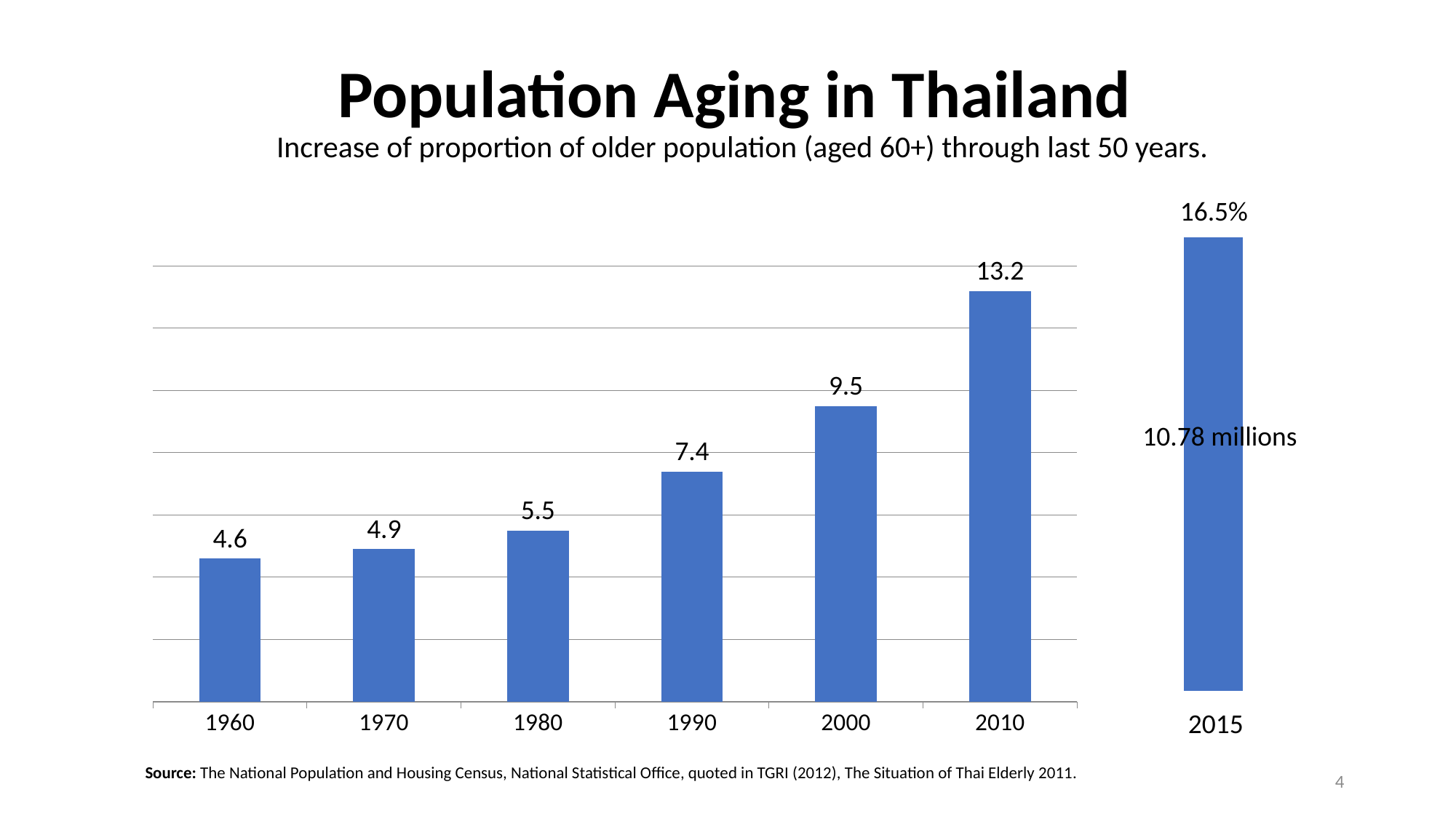
What is the difference between the values for 2000 and 1990? 2.1 Do the values rise or fall from 1960 to 2010? rise How many bars are shown for the years 1960 through 2010? 6 Which is larger, the value for 1980 or the value for 2000? 2000 What is the difference between the values for 2010 and 1960? 8.6 What is the value shown for 1990? 7.4 What text is written on the 2015 bar? 10.78 millions Which year on the slide has the highest value? 2015 Which year from 1960 to 2010 has the lowest value? 1960 What percentage is shown above the 2015 bar? 16.5% What is the value shown for 1960? 4.6 What is the value shown for 2010? 13.2